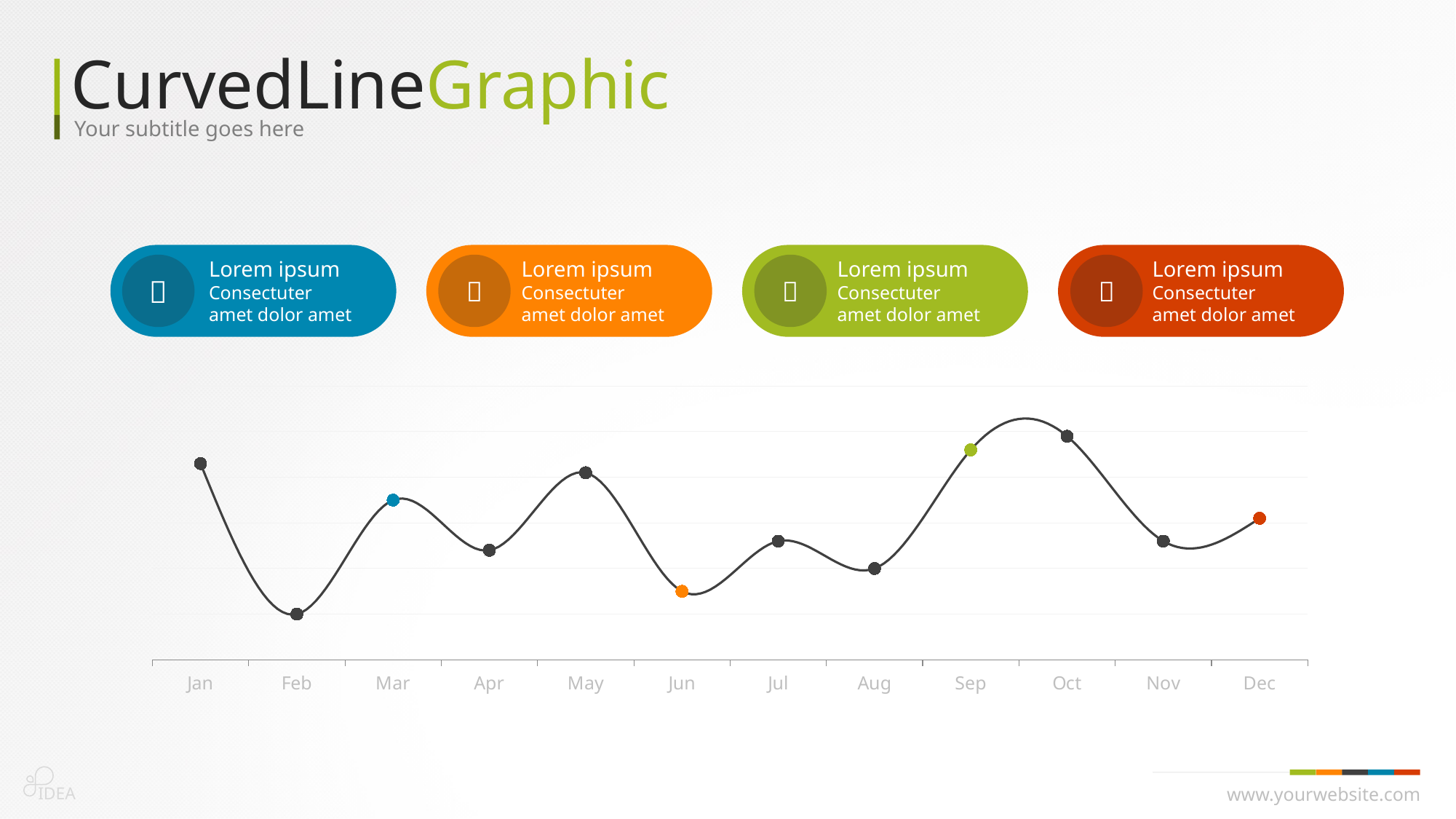
What is the title of the slide containing the chart? Curved Line Graphic Which is higher on the line, Jun or Jul? Jul Which is higher on the line, Jan or Feb? Jan What colour is the data point for Sep on the line? green Which is higher on the line, Apr or May? May Which month has the highest point on the line? Oct What kind of chart is shown on the slide? line chart Does the line rise or fall from Aug to Oct? rise Which month has the lowest point on the line? Feb Does the line rise or fall from Jan to Feb? fall How many months are labelled on the x axis of the chart? 12